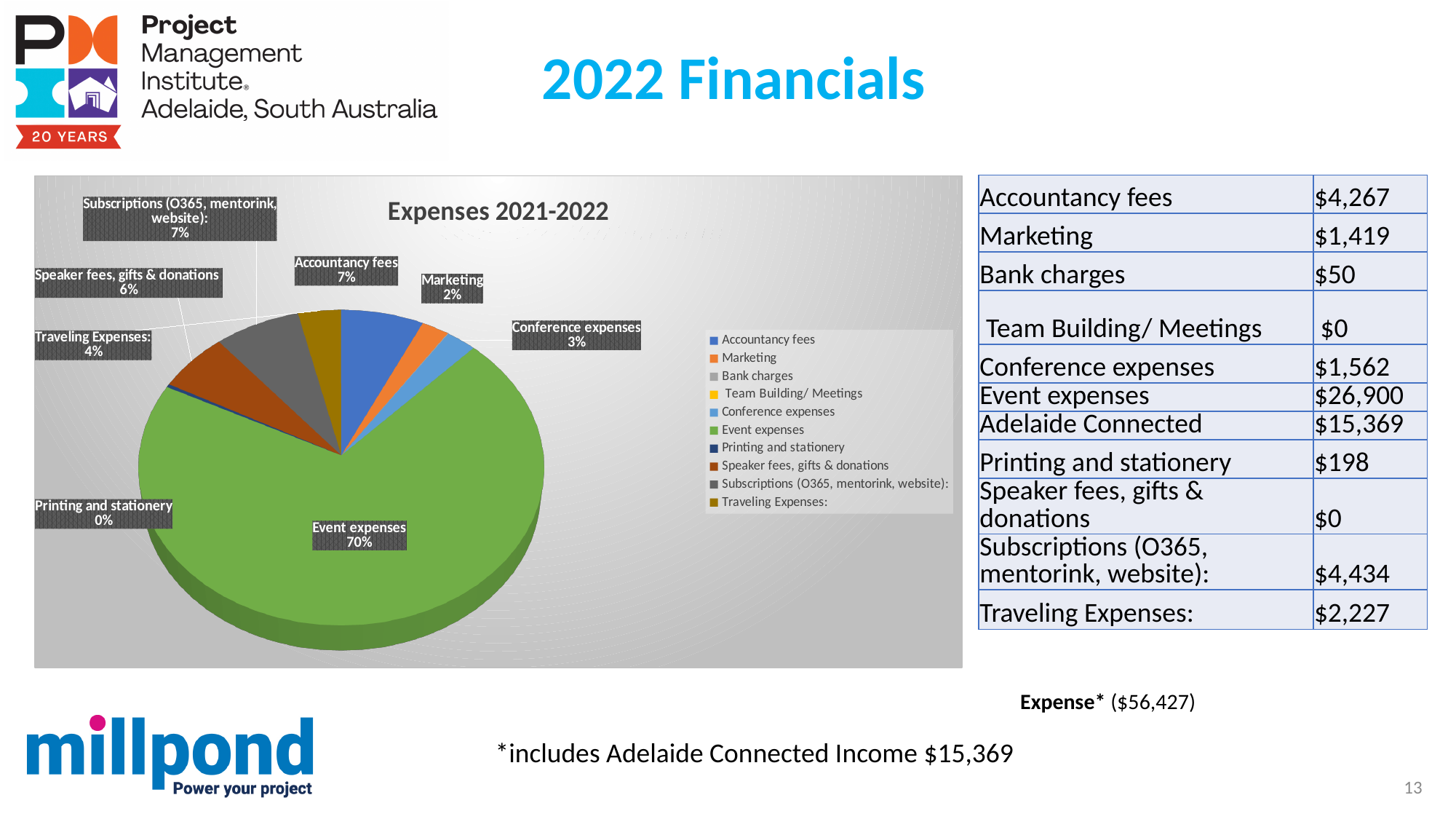
What is the difference in percentage points between Event expenses and Subscriptions (O365, mentorink, website)? 63 What percentage is shown for Traveling Expenses? 4% What percentage is shown for Speaker fees, gifts & donations? 6% What share of the pie is Event expenses? 70% Which category has the largest slice of the pie? Event expenses How many entries does the chart legend list? 10 What kind of chart is shown on the slide? pie chart What percentage is shown for Printing and stationery? 0% What percentage is shown for Marketing? 2% What is the title of the chart? Expenses 2021-2022 What percentage is shown for Accountancy fees? 7% What percentage is shown for Conference expenses? 3%